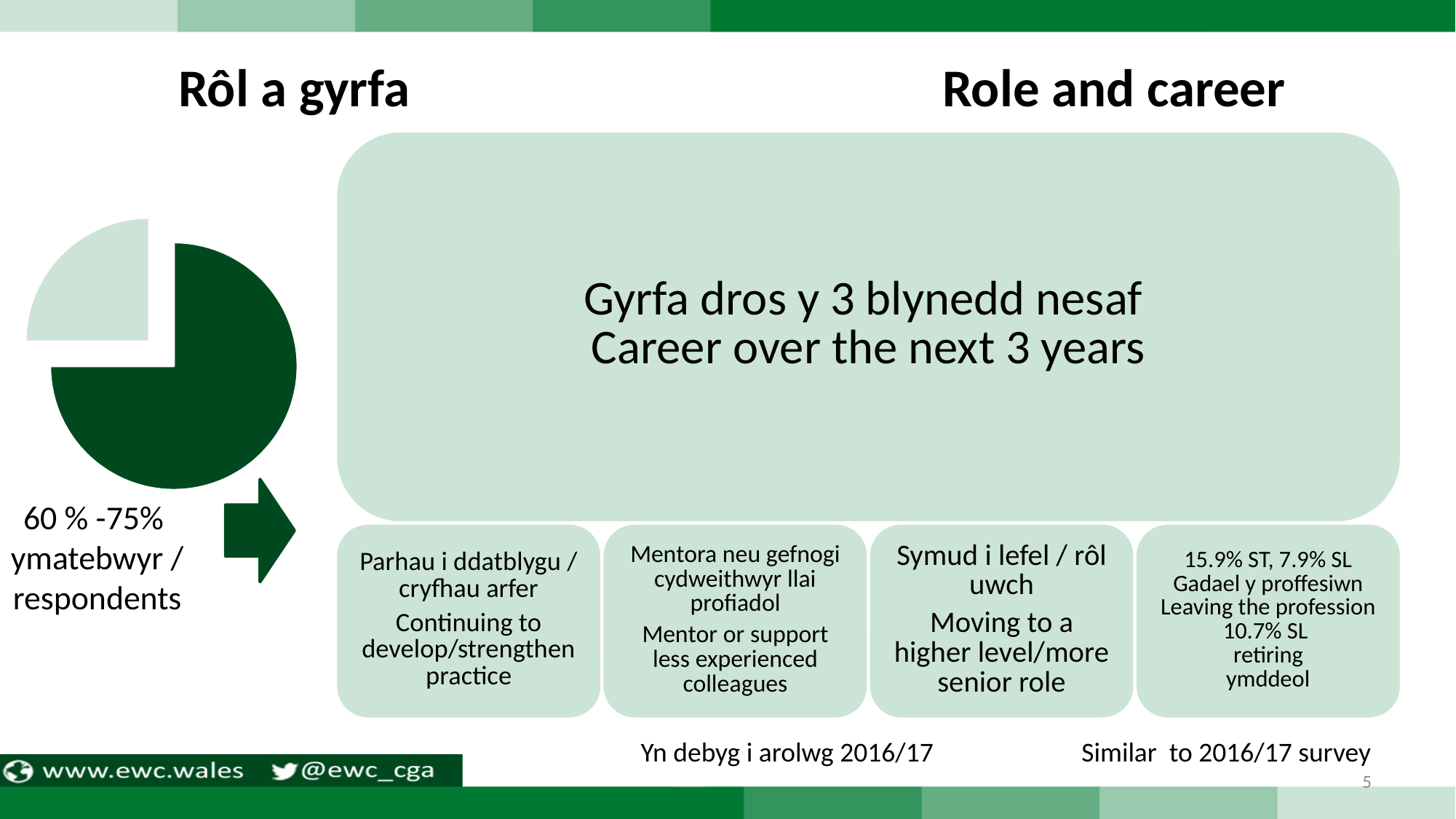
What text is printed directly below the pie chart on the left of the slide? 60 % -75% ymatebwyr / respondents In the pie chart on the left of the slide, is the light green slice's share greater or less than 50%? less What colour is the largest slice of the pie chart on the left of the slide? dark green What kind of chart is shown on the left of the slide? pie chart Which slice of the pie chart on the left of the slide is pulled out (exploded) from the rest? the light green slice How many slices does the pie chart on the left of the slide have? 2 In the pie chart on the left of the slide, which slice is larger, the dark green slice or the light green slice? the dark green slice In the pie chart on the left of the slide, is the dark green slice's share greater or less than 50%? greater